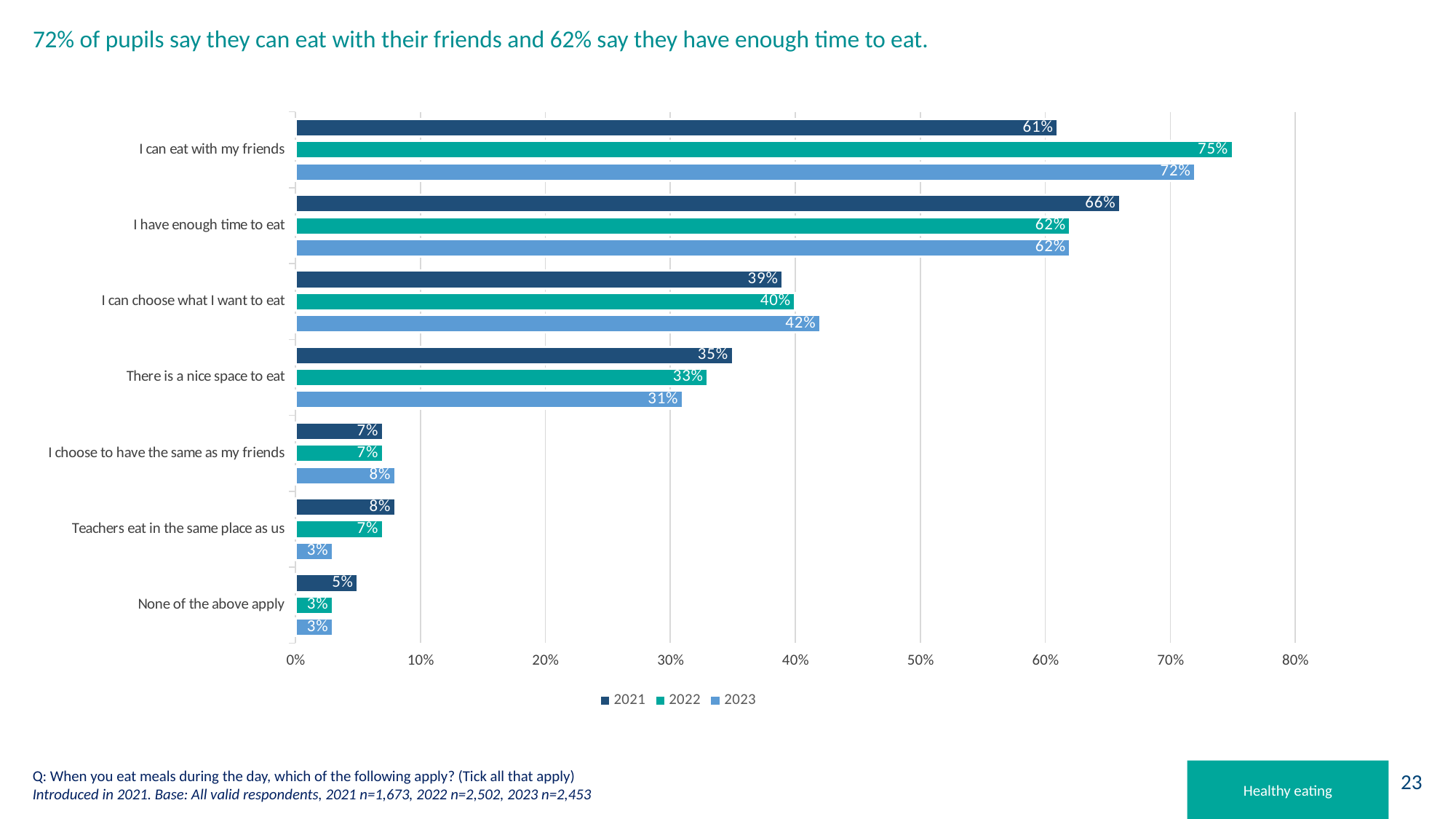
How many categories are shown on the chart? 7 What percentage said 'Teachers eat in the same place as us' in 2023? 3% Did the value for 'I can choose what I want to eat' rise or fall from 2021 to 2023? Rise Which year does the light blue series in the legend represent? 2023 What is the difference between the 2022 and 2021 values for 'I can eat with my friends'? 14 percentage points What type of chart is shown on the slide? Bar chart Which category had the lowest value in 2021? None of the above apply Which category had the highest value in 2022? I can eat with my friends How many series does the legend list? 3 What was the value for 'I have enough time to eat' in 2021? 66% What percentage of pupils said 'I can eat with my friends' in 2023? 72% Which is larger for 'There is a nice space to eat': the 2021 value or the 2023 value? 2021